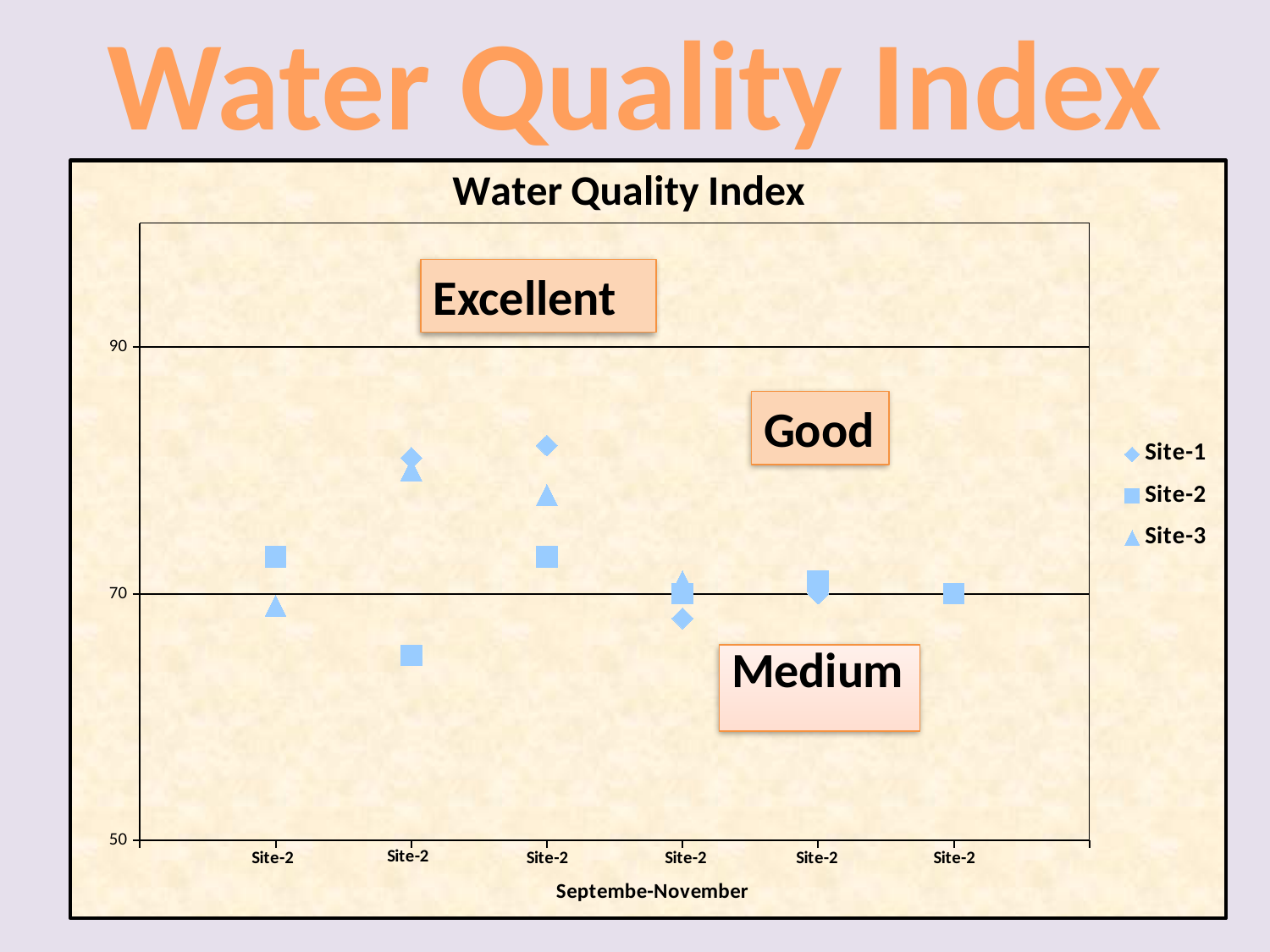
Is the Site-3 value at the first x-axis position greater or less than 70? less Is the Site-2 value at the first x-axis position greater or less than 70? greater Which series has the lowest plotted point on the chart? Site-2 At the third x-axis position, which series has the higher value, Site-1 or Site-2? Site-1 How many series does the chart legend list? 3 What are the series names listed in the chart legend? Site-1, Site-2, Site-3 How many positions are labelled along the x axis of the chart? 6 Is the Site-1 value at the third x-axis position greater or less than 90? less What is the title of the x axis of the chart? Septembe-November What kind of chart is shown on the slide? scatter chart